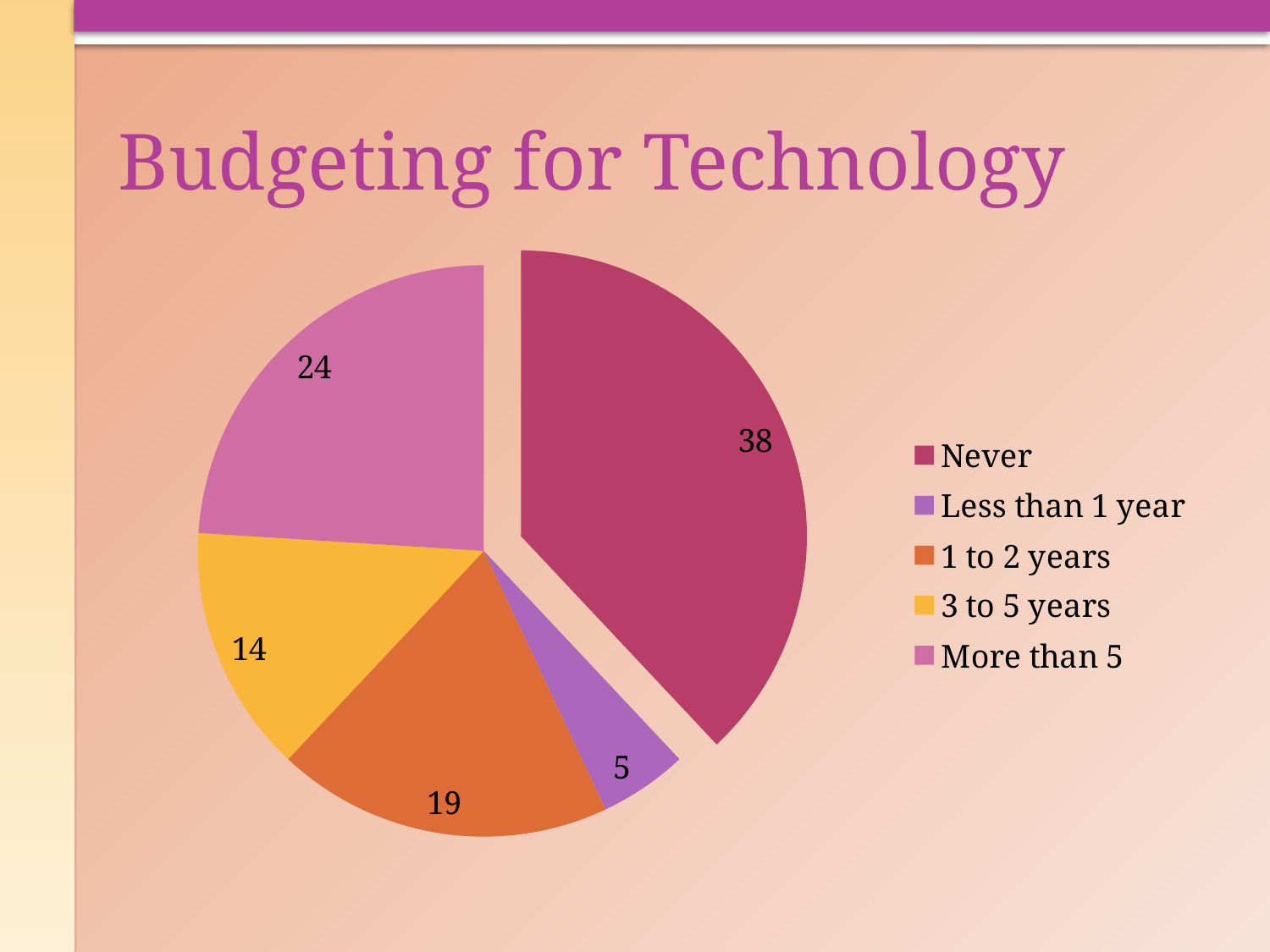
What is the value for the 1 to 2 years slice? 19 How many categories does the pie chart have? 5 Which category has the smallest slice? Less than 1 year What is the value for the Never slice? 38 What is the difference between the Never value and the More than 5 value? 14 What is the value for the 3 to 5 years slice? 14 What is the value for the Less than 1 year slice? 5 Which category has the largest slice? Never What is the title of the slide containing the pie chart? Budgeting for Technology What type of chart is shown on the slide? Pie chart Which is larger, the 1 to 2 years slice or the 3 to 5 years slice? 1 to 2 years What is the value for the More than 5 slice? 24